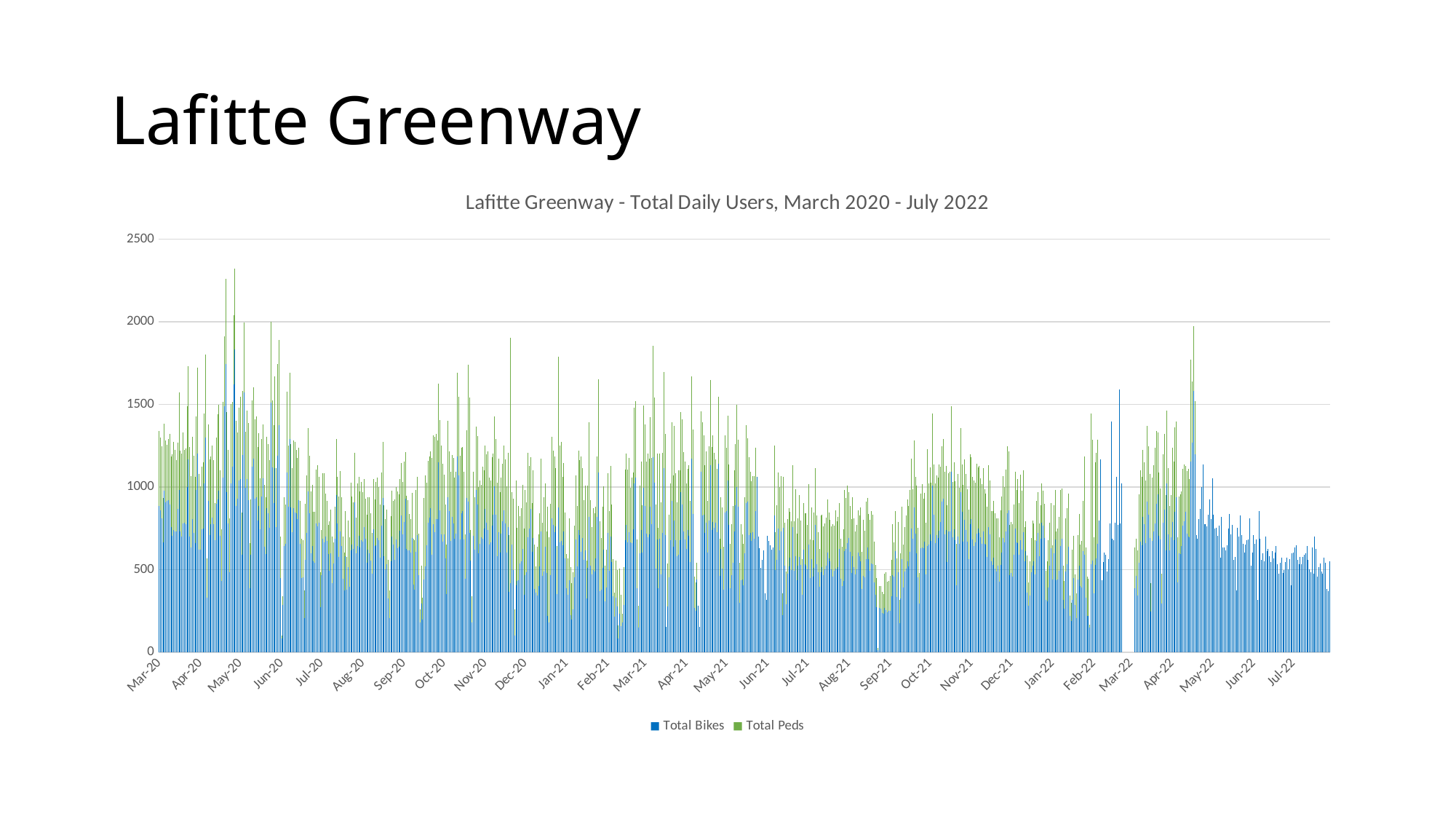
How many month labels are shown on the x axis? 29 Are the Total Bikes values in Jul-22 greater or less than 1000? less What kind of chart is shown on the slide? Bar chart How many series does the legend list? 2 Is the highest value on the chart greater or less than 2500? less What is the title of the chart? Lafitte Greenway - Total Daily Users, March 2020 - July 2022 What are the two series named in the legend? Total Bikes and Total Peds